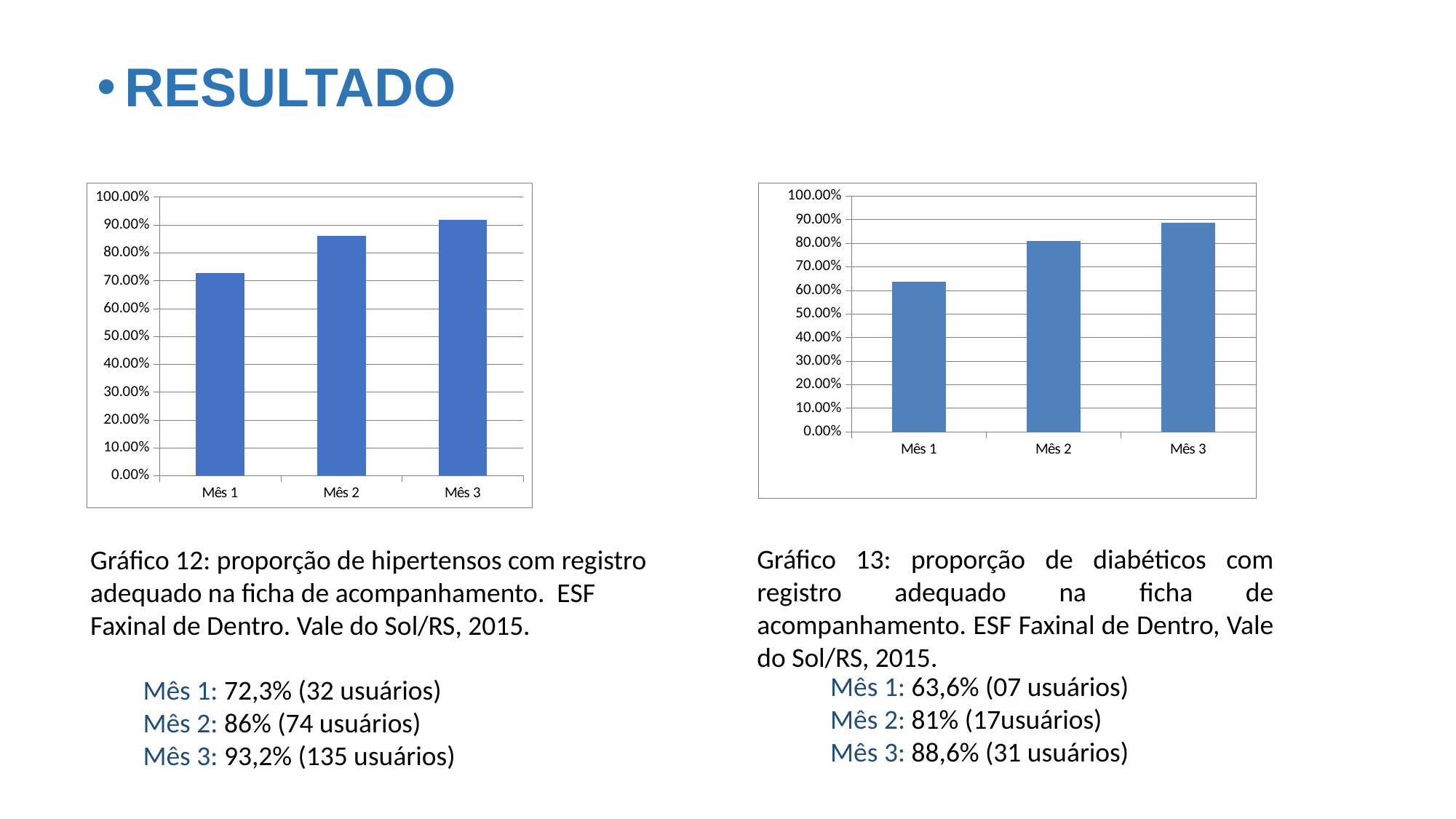
In the left chart (Gráfico 12), do the values rise or fall from Mês 1 to Mês 3? rise In the right chart (Gráfico 13), which is larger, the value for Mês 1 or the value for Mês 2? Mês 2 What kind of chart is the right chart (Gráfico 13)? bar chart In the right chart (Gráfico 13), is the value for Mês 3 greater or less than 80.00%? greater In the right chart (Gráfico 13), is the value for Mês 1 greater or less than 70.00%? less In the left chart (Gráfico 12), is the value for Mês 1 greater or less than 80.00%? less In the right chart (Gráfico 13), which month has the lowest value? Mês 1 In the right chart (Gráfico 13), which month has the highest value? Mês 3 In the left chart (Gráfico 12), which month has the highest value? Mês 3 How many bars are shown in the left chart (Gráfico 12)? 3 In the left chart (Gráfico 12), which month has the lowest value? Mês 1